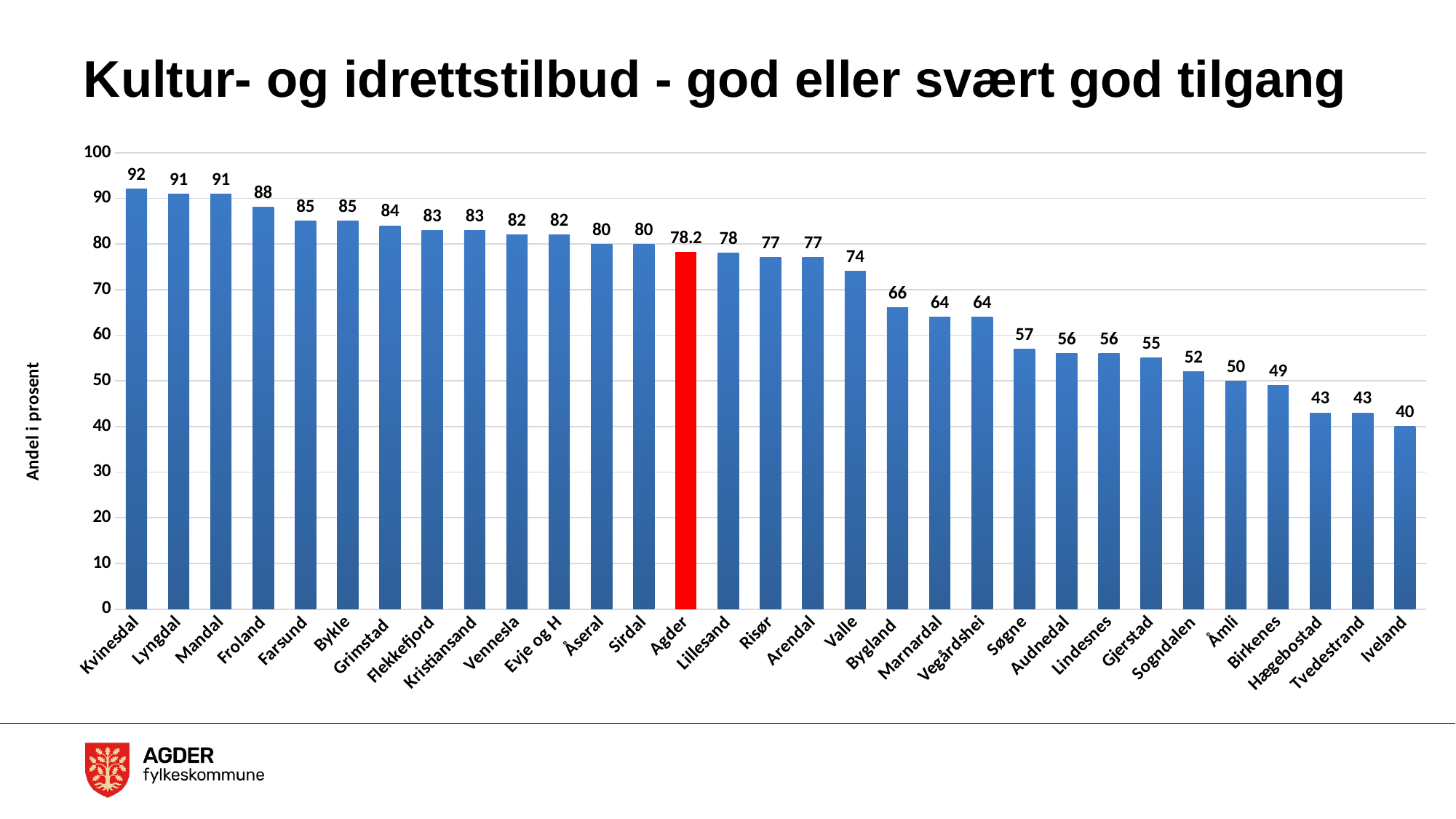
What is the value for Kristiansand? 83 Which municipality has the highest value? Kvinesdal What is the value for Iveland? 40 What is the difference between the values for Kvinesdal and Iveland? 52 What kind of chart is shown on the slide? Bar chart Which municipality has the lowest value? Iveland Which has a larger value, Bygland or Søgne? Bygland What is the value for Agder? 78.2 Is the value for Valle greater or less than 70? greater How many municipalities/categories are shown on the x axis? 31 Which bar is coloured red instead of blue? Agder Do the values rise or fall from left to right along the x axis? Fall